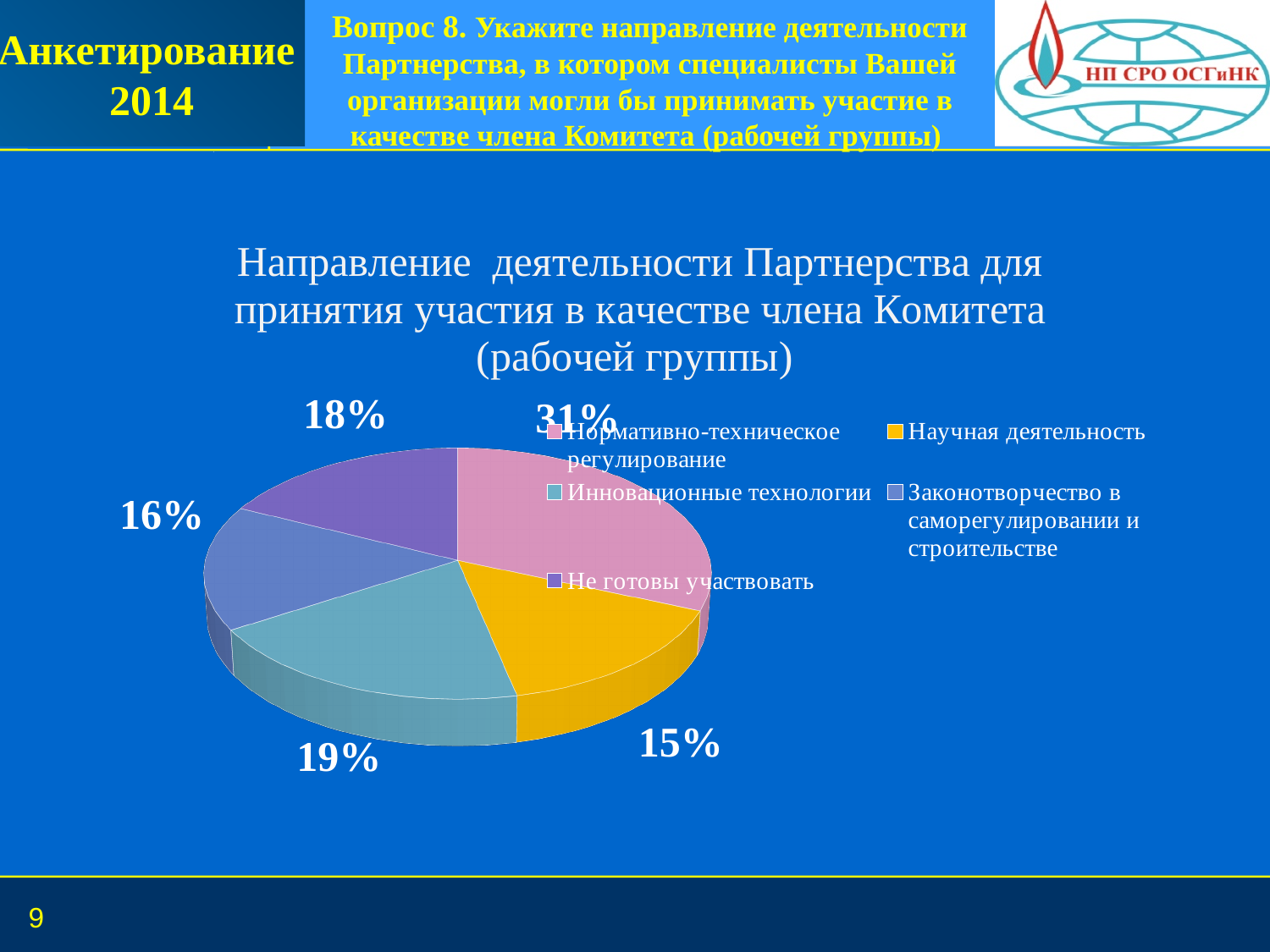
Which category has the largest share of the pie? Нормативно-техническое регулирование What type of chart is shown on the slide? pie chart Which has a larger share: "Инновационные технологии" or "Не готовы участвовать"? Инновационные технологии What share of the pie does "Законотворчество в саморегулировании и строительстве" have? 16% What share of the pie does "Нормативно-техническое регулирование" have? 31% How many slices does the pie chart have? 5 Which category has the smallest share of the pie? Научная деятельность What is the difference between the shares of "Нормативно-техническое регулирование" and "Научная деятельность"? 16% What share of the pie does "Инновационные технологии" have? 19% What colour is the slice for "Научная деятельность"? yellow What share of the pie does "Не готовы участвовать" have? 18% What share of the pie does "Научная деятельность" have? 15%